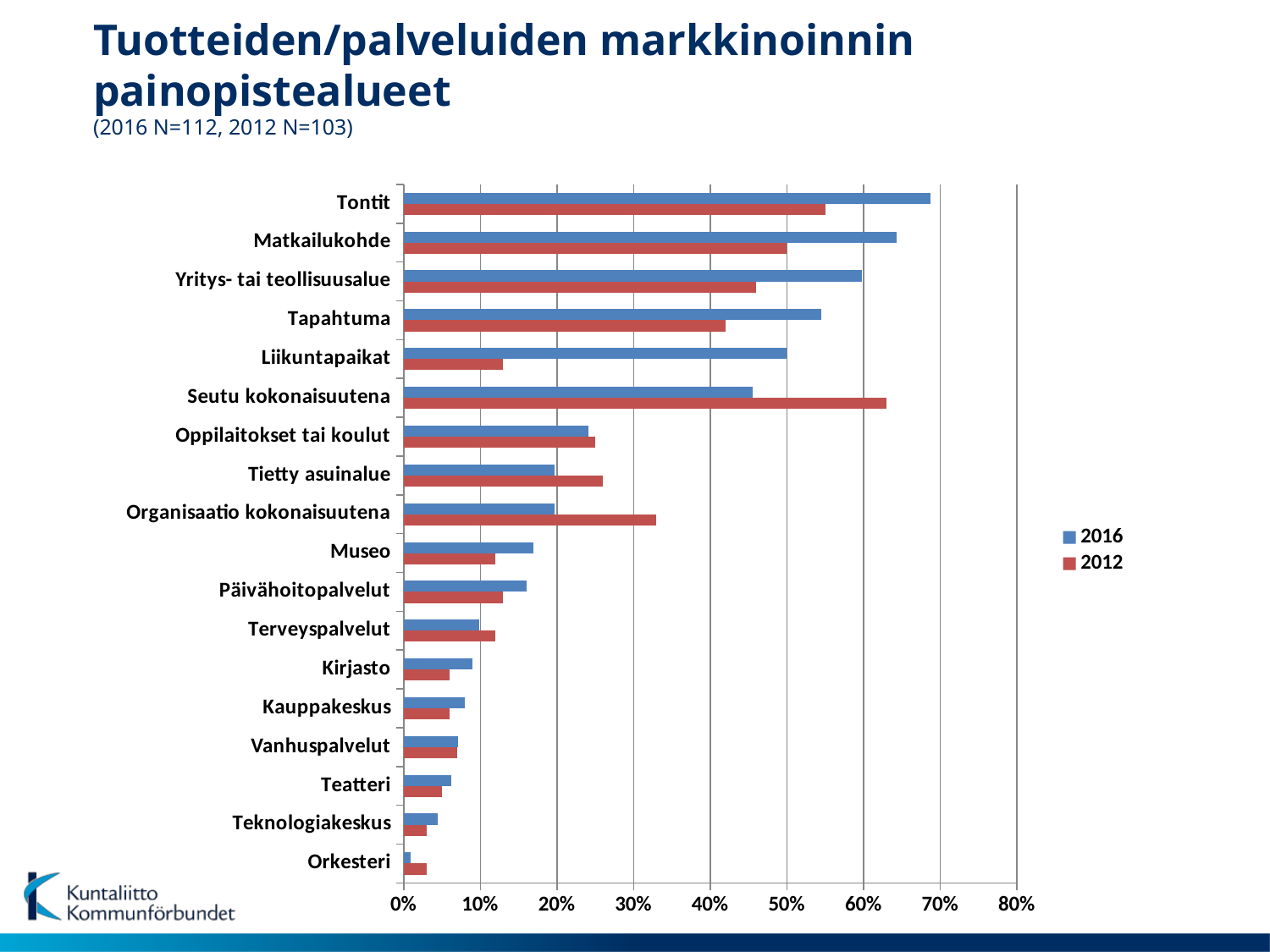
Is the 2016 value for Tontit greater or less than 60%? greater Which colour represents the 2012 series in the legend? red For Seutu kokonaisuutena, which series has the larger value, 2016 or 2012? 2012 Which category has the lowest value for the 2016 series? Orkesteri Is the 2016 value for Museo greater or less than 20%? less For Liikuntapaikat, which series has the larger value, 2016 or 2012? 2016 Which category has the highest value for the 2012 series? Seutu kokonaisuutena How many categories are plotted on the chart? 18 How many series does the legend list? 2 What kind of chart is shown on the slide? bar chart Is the 2012 value for Organisaatio kokonaisuutena greater or less than 30%? greater Which category has the highest value for the 2016 series? Tontit